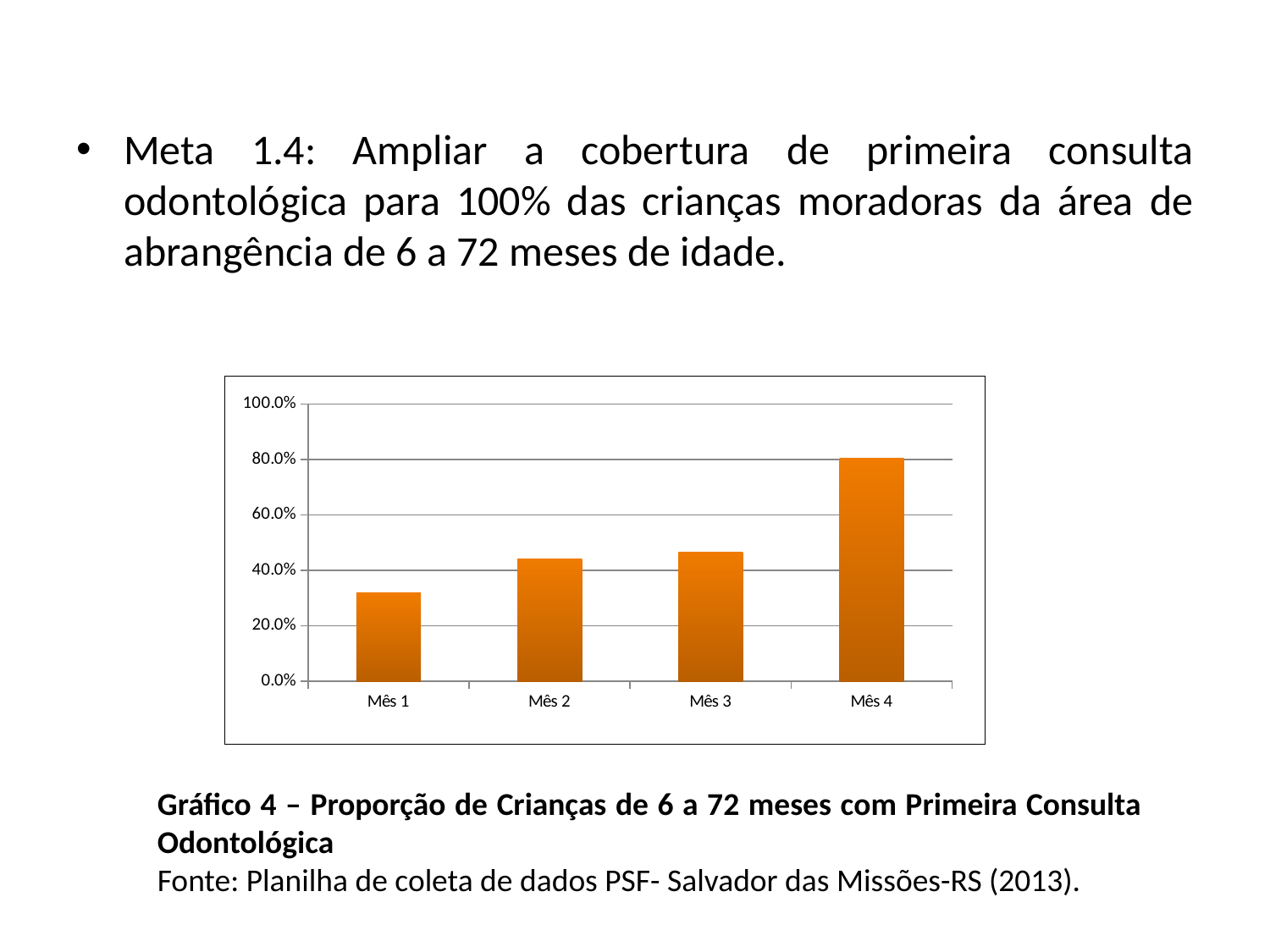
What kind of chart is shown on the slide? bar chart How many months (categories) are plotted on the chart? 4 Which is larger, the value for Mês 1 or the value for Mês 4? Mês 4 What is the maximum value shown on the vertical axis of the chart? 100.0% Do the values rise or fall from Mês 1 to Mês 4? rise Is the value for Mês 2 greater or less than 20.0%? greater Is the value for Mês 1 greater or less than 20.0%? greater Is the value for Mês 4 greater or less than 60.0%? greater Which month has the lowest value on the chart? Mês 1 Which month has the highest proportion of children with a first dental consultation? Mês 4